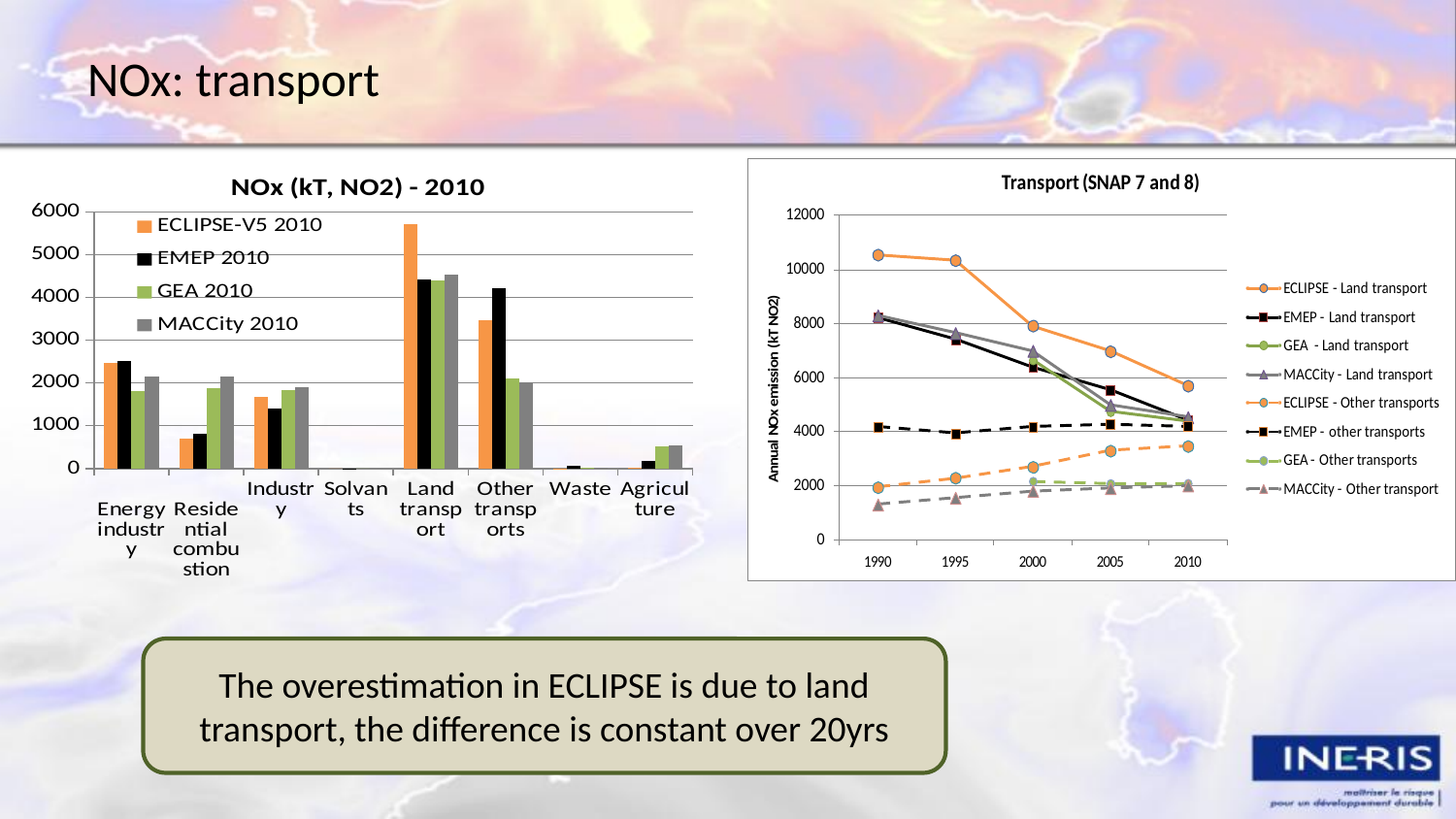
In the right chart "Transport (SNAP 7 and 8)", does the ECLIPSE - Land transport series rise or fall from 1990 to 2010? fall What kind of chart is the right chart titled "Transport (SNAP 7 and 8)"? line chart In the left chart "NOx (kT, NO2) - 2010", which category has the highest ECLIPSE-V5 2010 value? Land transport In the left chart "NOx (kT, NO2) - 2010", how many series does the legend list? 4 In the left chart "NOx (kT, NO2) - 2010", for Residential combustion, which is larger: the ECLIPSE-V5 2010 value or the MACCity 2010 value? MACCity 2010 What kind of chart is the left chart titled "NOx (kT, NO2) - 2010"? bar chart In the left chart "NOx (kT, NO2) - 2010", for Other transports, which is larger: the ECLIPSE-V5 2010 value or the GEA 2010 value? ECLIPSE-V5 2010 In the right chart "Transport (SNAP 7 and 8)", how many years are shown on the x axis? 5 In the right chart "Transport (SNAP 7 and 8)", how many series does the legend list? 8 In the right chart "Transport (SNAP 7 and 8)", is the ECLIPSE - Land transport value in 1990 greater or less than 10000? greater In the left chart "NOx (kT, NO2) - 2010", how many categories are shown on the x axis? 8 In the left chart "NOx (kT, NO2) - 2010", is the ECLIPSE-V5 2010 value for Land transport greater or less than 5000? greater